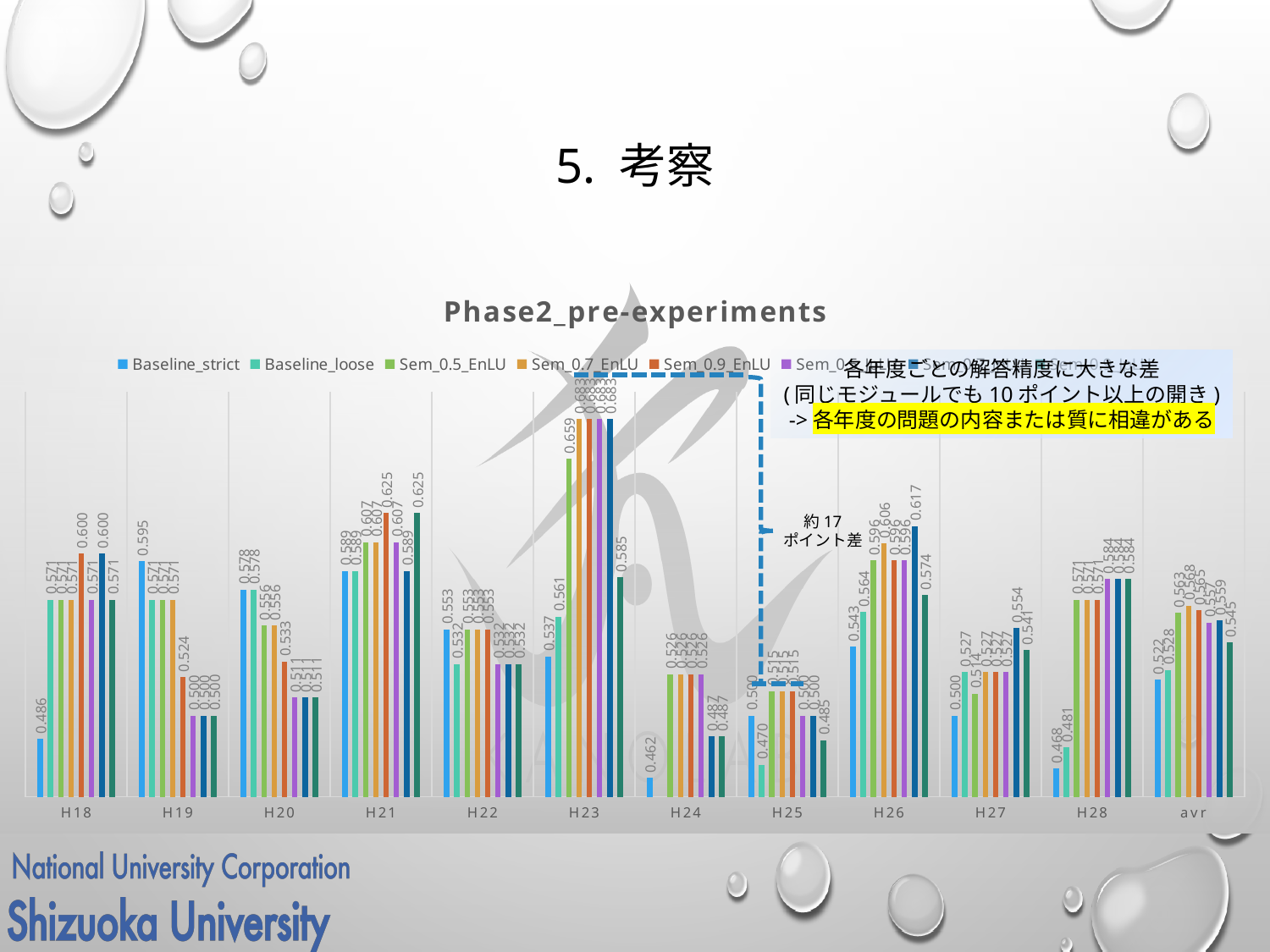
What is the Baseline_strict value for avr? 0.522 What is the Baseline_strict value for H19? 0.595 What is the Baseline_strict value for H18? 0.486 What is the Sem_0.5_EnLU value for H23? 0.659 Which category has the highest Baseline_strict value? H19 What is the Baseline_strict value for H24? 0.462 Which category has the lowest Baseline_strict value? H24 What is the difference between the Baseline_strict values for H19 and H24? 0.133 What is the Baseline_loose value for H25? 0.470 What kind of chart is shown on the slide? bar chart What is the title of the chart? Phase2_pre-experiments How many categories are shown along the x axis of the chart? 12